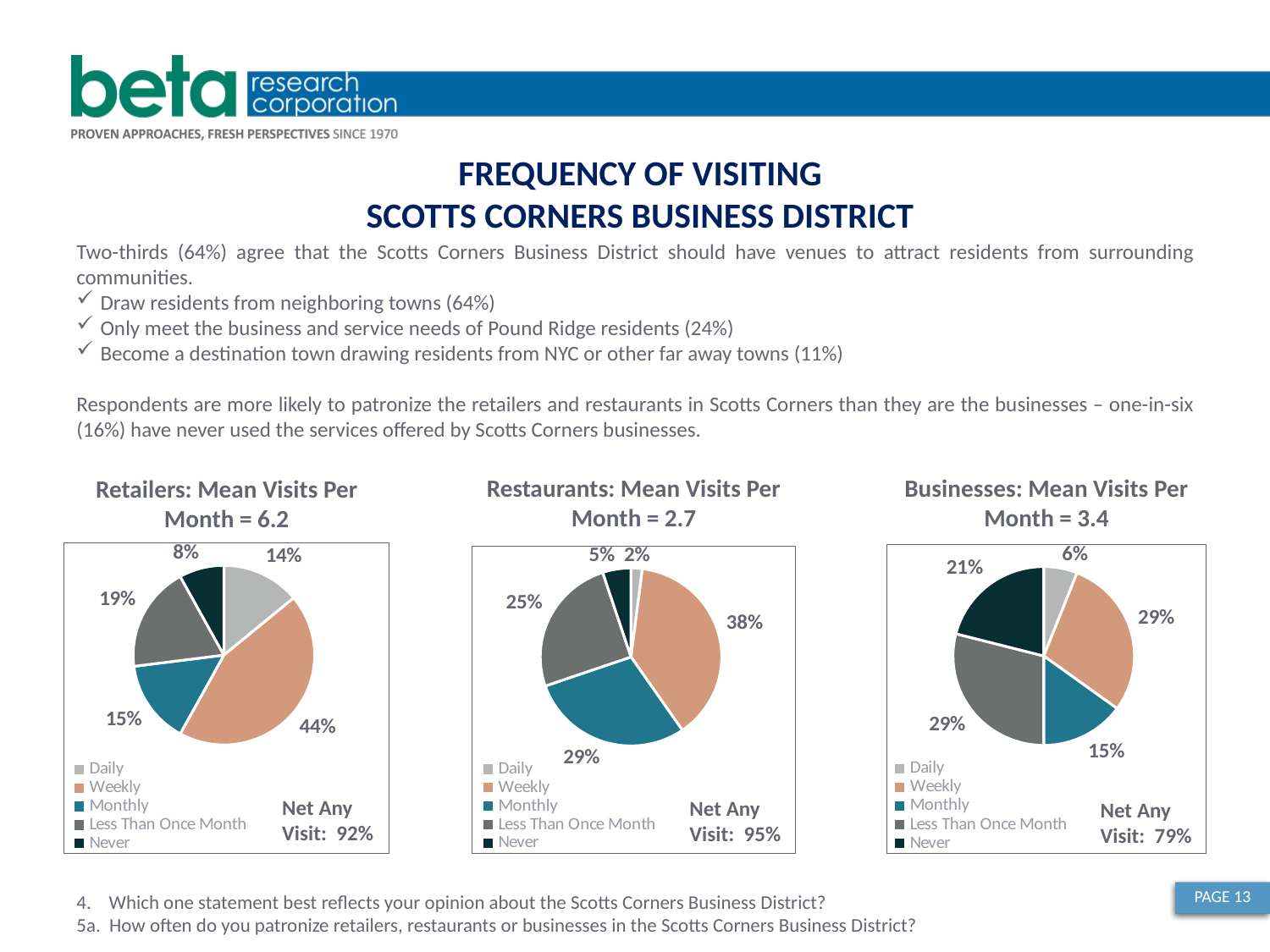
How many slices does the Restaurants pie chart have? 5 In the Businesses pie chart, what percentage of respondents never visit? 21% What type of chart is used to show the Retailers visit frequency? Pie chart In the Businesses pie chart, what is the difference between the Weekly share and the Monthly share? 14% In the Restaurants pie chart, what percentage of respondents visit monthly? 29% In the Restaurants pie chart, which visit frequency has the smallest share? Daily How many entries does the legend of the Businesses pie chart list? 5 In the Retailers pie chart, which visit frequency has the largest share? Weekly What is the mean visits per month stated in the title of the Businesses chart? 3.4 What Net Any Visit percentage is shown for the Restaurants chart? 95% In the Retailers pie chart, is the share for Less Than Once Month larger or smaller than the share for Monthly? larger In the Retailers pie chart, what percentage of respondents visit weekly? 44%